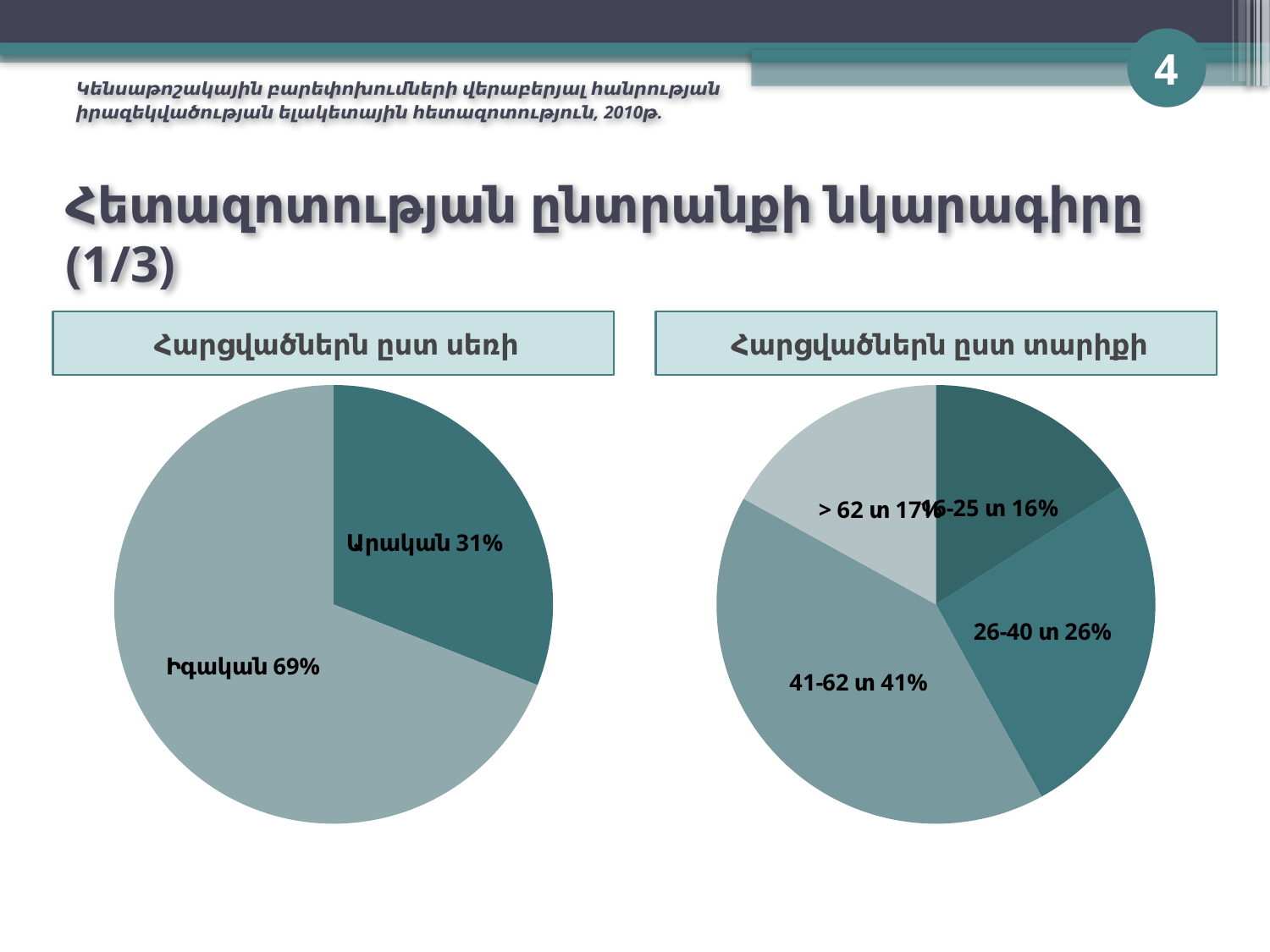
In the left chart titled "Հարցվածներն ըստ սեռի", what is the difference in percentage points between Իգական and Արական? 38 In the right chart titled "Հարցվածներն ըստ տարիքի", what percentage is labelled "41-62 տ"? 41% In the right chart titled "Հարցվածներն ըստ տարիքի", which is larger: the share for 26-40 տ or the share for > 62 տ? 26-40 տ In the left chart titled "Հարցվածներն ըստ սեռի", what percentage is labelled "Արական"? 31% What type of chart is used for "Հարցվածներն ըստ տարիքի" on the right of the slide? Pie chart In the right chart titled "Հարցվածներն ըստ տարիքի", which age group has the largest share? 41-62 տ In the right chart titled "Հարցվածներն ըստ տարիքի", which age group has the smallest share? 16-25 տ In the right chart titled "Հարցվածներն ըստ տարիքի", what percentage is labelled "26-40 տ"? 26% In the left chart titled "Հարցվածներն ըստ սեռի", how many slices does the pie have? 2 In the right chart titled "Հարցվածներն ըստ տարիքի", how many age groups are shown? 4 In the left chart titled "Հարցվածներն ըստ սեռի", which slice is the largest? Իգական In the left chart titled "Հարցվածներն ըստ սեռի", what percentage is labelled "Իգական"? 69%